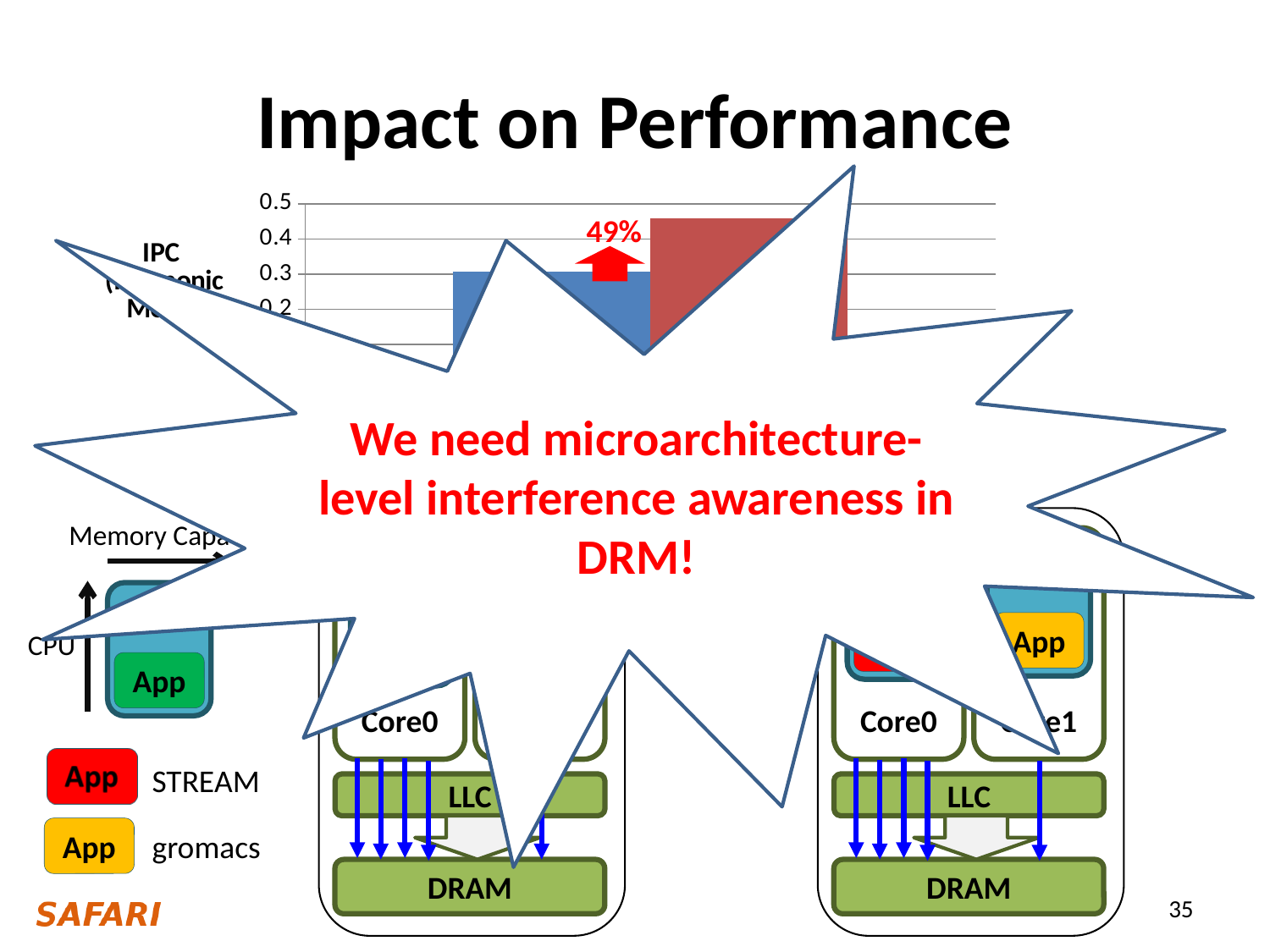
Is the value of the red bar greater or less than 0.5? less Is the value of the blue bar greater or less than 0.4? less Is the value of the red bar greater or less than 0.4? greater Which bar is taller, the red bar or the blue bar? the red bar What is the highest tick value shown on the chart's y-axis? 0.5 What percentage improvement is annotated above the bars in the chart? 49% What kind of chart is shown on the slide? bar chart